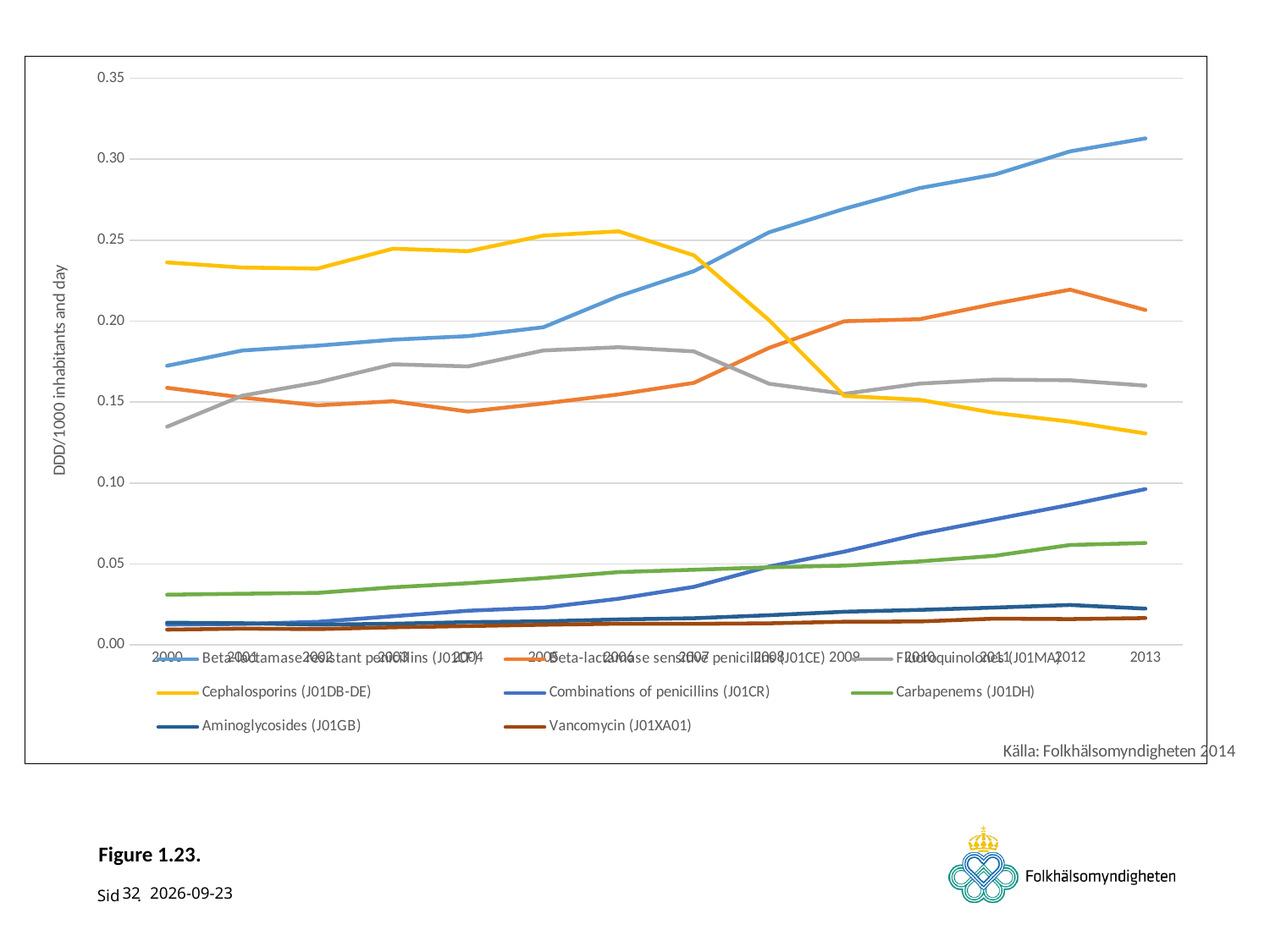
Is the value for Cephalosporins (J01DB-DE) in 2000 greater or less than 0.20? greater What is the label of the y axis? DDD/1000 inhabitants and day Which series has the highest value in 2000? Cephalosporins (J01DB-DE) What source is cited at the bottom of the chart? Källa: Folkhälsomyndigheten 2014 In 2013, which is larger: Combinations of penicillins (J01CR) or Carbapenems (J01DH)? Combinations of penicillins (J01CR) Is the value for Carbapenems (J01DH) in 2013 greater or less than 0.05? greater What kind of chart is shown on the slide? line chart Is the value for Combinations of penicillins (J01CR) in 2013 greater or less than 0.05? greater How many years are plotted along the x axis? 14 Do the values for Combinations of penicillins (J01CR) rise or fall from 2000 to 2013? rise How many series does the legend list? 8